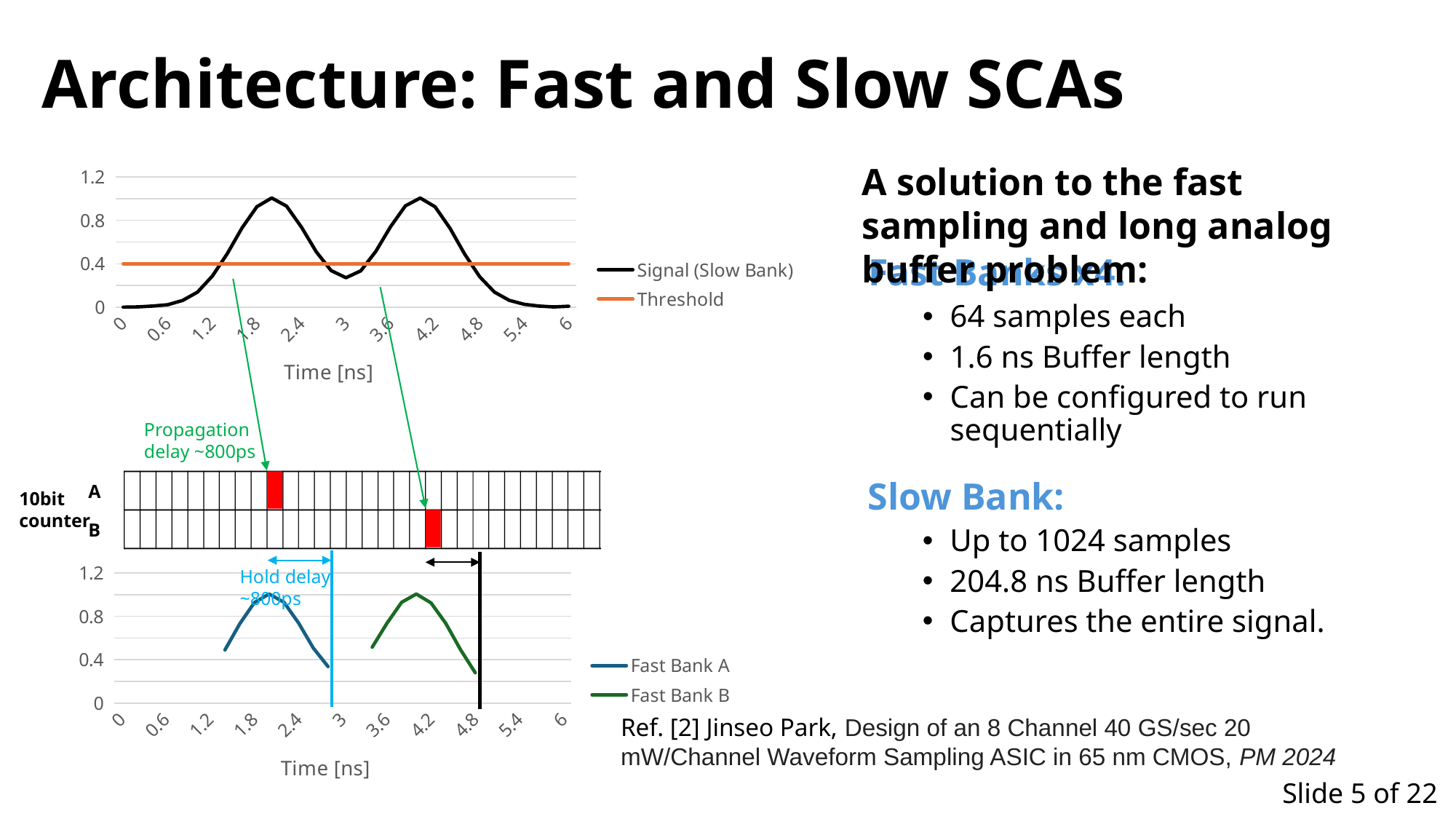
In the top chart, what are the two legend entries? Signal (Slow Bank) and Threshold How many series does the legend of the top chart list? 2 In the top chart, how many peaks does the Signal (Slow Bank) curve have? 2 In the top chart, is the Signal (Slow Bank) value at 1.8 ns greater or less than 0.4? greater What is the x-axis title of the bottom chart? Time [ns] In the top chart, is the Signal (Slow Bank) value at 3 ns greater or less than 0.4? less In the top chart, at what value does the Threshold line sit on the y axis? 0.4 In the top chart, is the Signal (Slow Bank) value at 0.6 ns greater or less than 0.4? less How many series does the legend of the bottom chart list? 2 What kind of chart is the top chart on the slide? Line chart In the top chart, does the Threshold line rise, fall or stay flat along the x axis? Stays flat